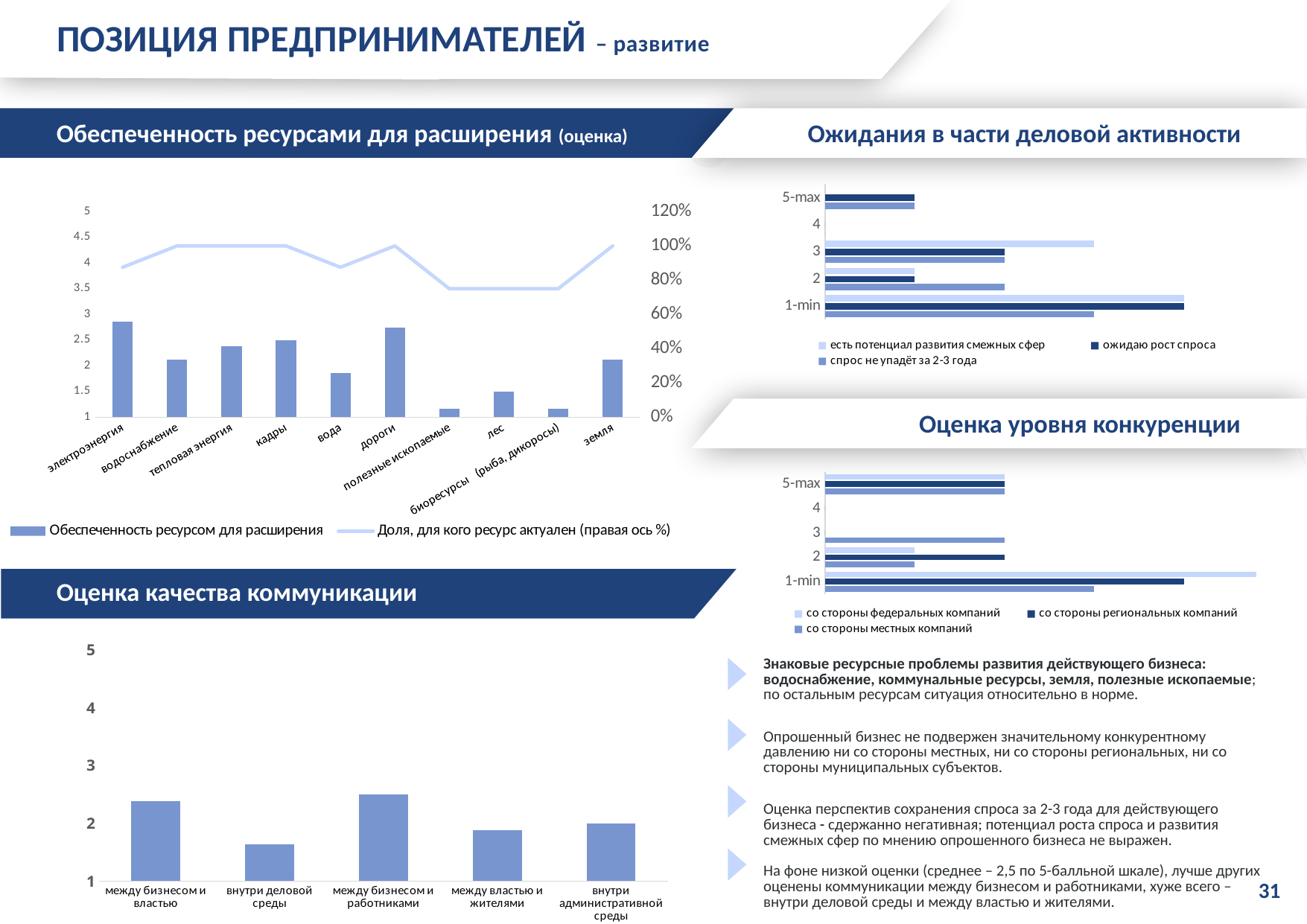
In the 'Оценка качества коммуникации' chart, which is larger: 'между бизнесом и властью' or 'внутри деловой среды'? между бизнесом и властью In the 'Обеспеченность ресурсами для расширения' chart, how many series does the legend list? 2 In the 'Оценка качества коммуникации' chart, which category has the lowest value? внутри деловой среды In the 'Обеспеченность ресурсами для расширения' chart, is the bar for 'полезные ископаемые' greater or less than 1.5? less In the 'Оценка качества коммуникации' chart, is the value for 'внутри деловой среды' greater or less than 2? less In the 'Ожидания в части деловой активности' chart, how many series does the legend list? 3 What kind of chart is the 'Оценка качества коммуникации' chart? bar chart In the 'Оценка уровня конкуренции' chart, what is the legend entry shown with the darkest blue colour? со стороны региональных компаний In the 'Обеспеченность ресурсами для расширения' chart, how many categories are on the x axis? 10 In the 'Обеспеченность ресурсами для расширения' chart, is the bar for 'электроэнергия' greater or less than 2.5? greater In the 'Оценка качества коммуникации' chart, how many categories are shown? 5 In the 'Оценка качества коммуникации' chart, which category has the highest value? между бизнесом и работниками